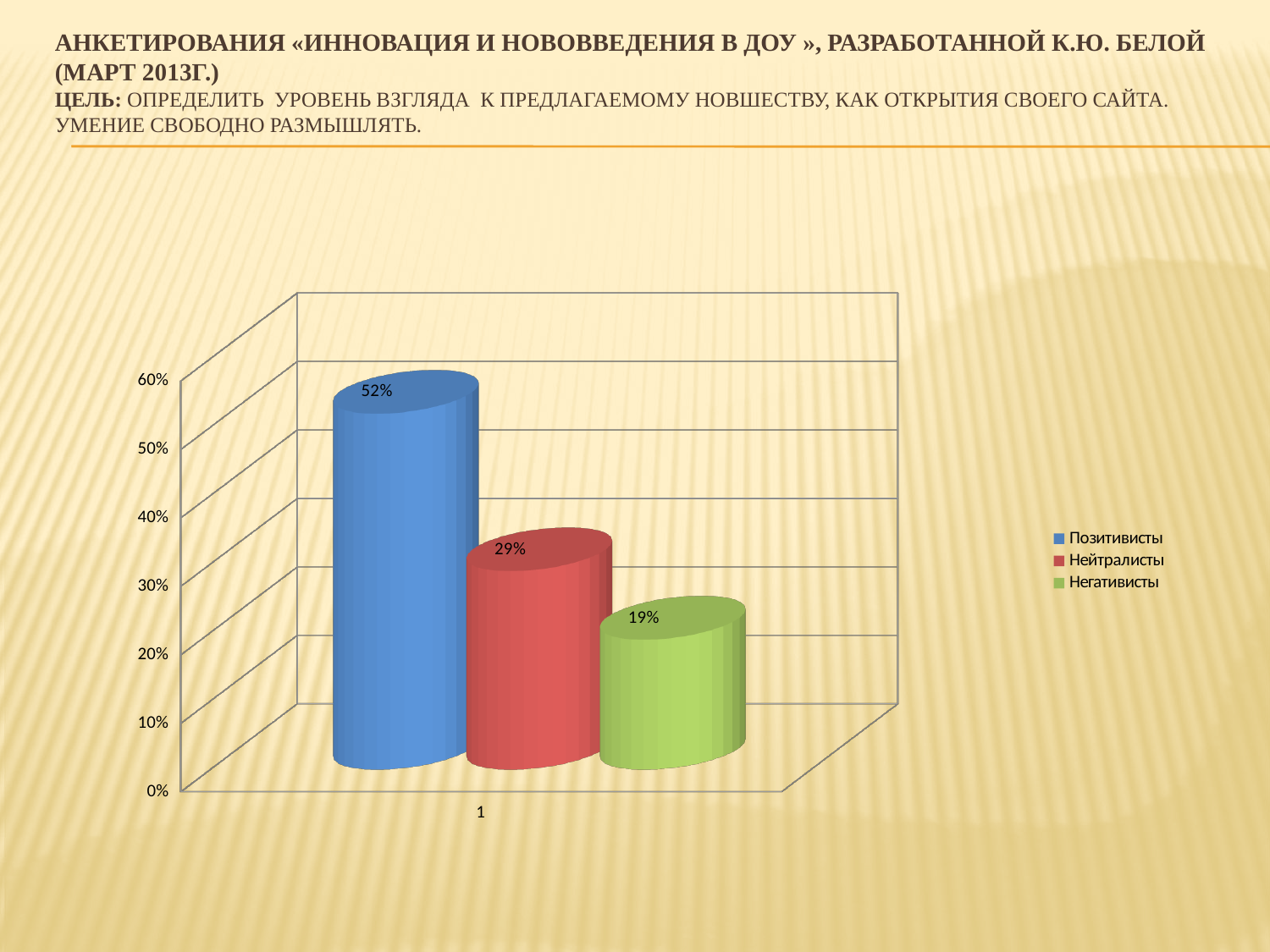
How many series does the legend list? 3 What kind of chart is shown on the slide? bar chart What is the value for Нейтралисты? 29% Which is larger, the value for Нейтралисты or the value for Негативисты? Нейтралисты What is the difference between the values for Нейтралисты and Негативисты? 10% Is the value for Позитивисты greater or less than 50%? greater Which series has the lowest value? Негативисты What is the value for Позитивисты? 52% What is the value for Негативисты? 19% Which series has the highest value? Позитивисты What is the difference between the values for Позитивисты and Нейтралисты? 23% What colour is the bar for Негативисты? green